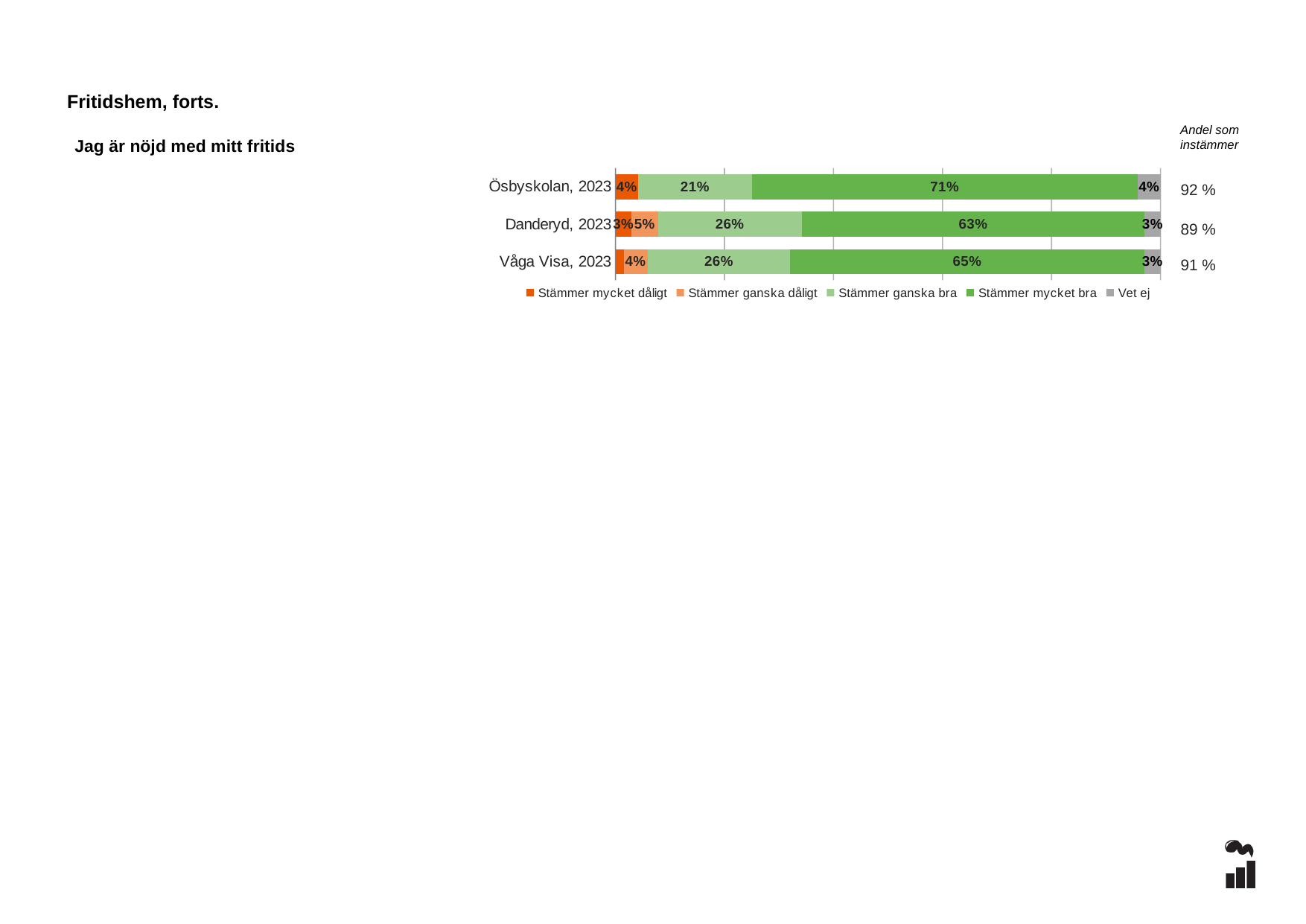
Which is larger: the 'Stämmer ganska bra' value for Ösbyskolan, 2023 or for Våga Visa, 2023? Våga Visa, 2023 What is the 'Stämmer mycket bra' value for Ösbyskolan, 2023? 71% What is the 'Stämmer mycket bra' value for Våga Visa, 2023? 65% How many series does the legend list? 5 What kind of chart is shown on the slide? Stacked bar chart Which category has the lowest 'Stämmer mycket bra' value? Danderyd, 2023 What is the 'Stämmer ganska dåligt' value for Danderyd, 2023? 5% What is the difference between the 'Stämmer mycket bra' values for Ösbyskolan, 2023 and Danderyd, 2023? 8% What is the 'Andel som instämmer' value shown for Danderyd, 2023? 89 % What is the 'Stämmer ganska bra' value for Danderyd, 2023? 26% Which category has the highest 'Stämmer mycket bra' value? Ösbyskolan, 2023 How many categories (bars) are shown in the chart? 3